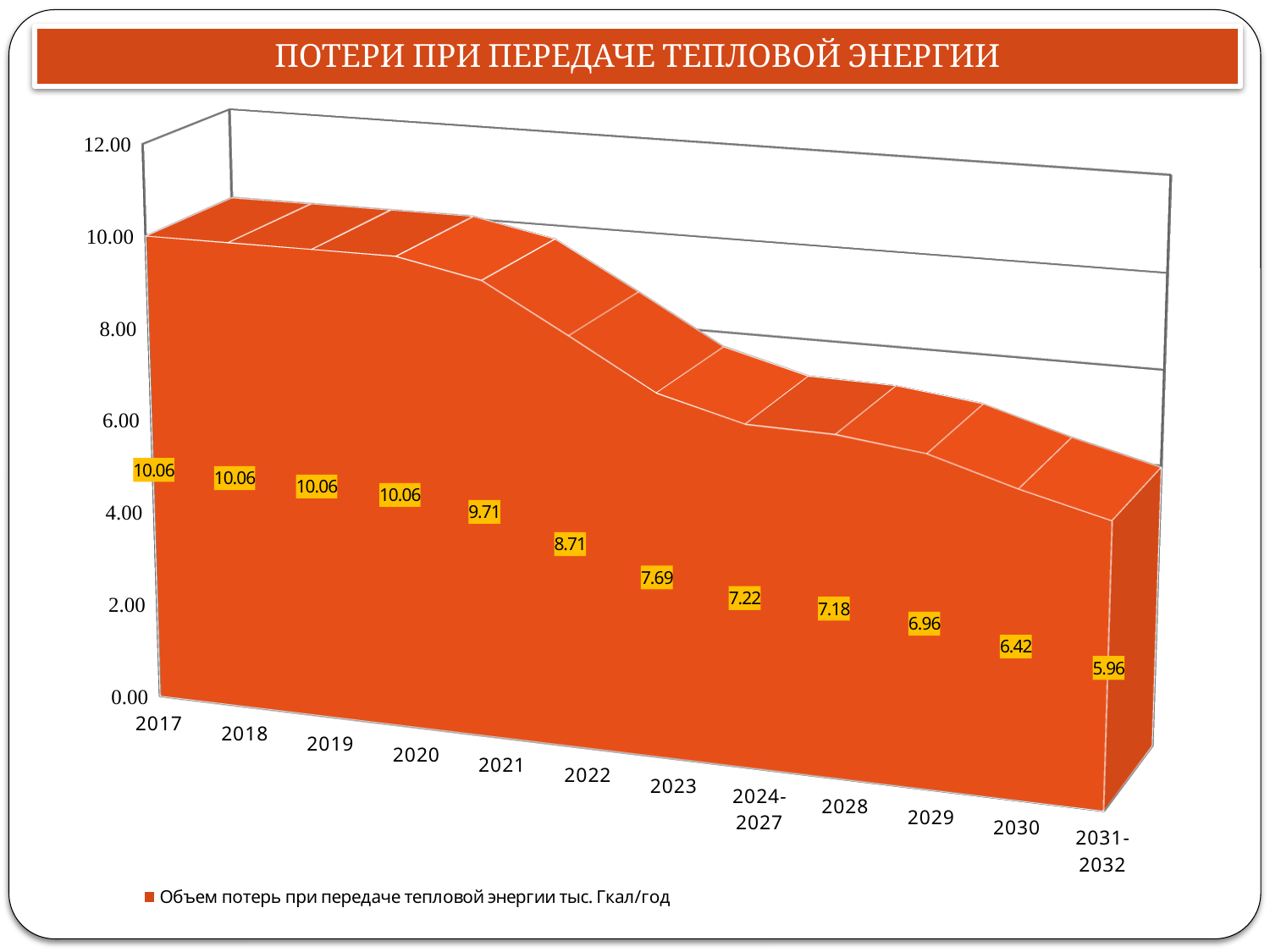
Which category has the lowest value? 2031-2032 What is the difference between the values for 2017 and 2031-2032? 4.10 Which is larger, the value for 2021 or the value for 2030? 2021 What is the value for 2029? 6.96 How many categories are shown on the x axis? 12 What is the value for 2024-2027? 7.22 What is the value for 2031-2032? 5.96 Do the values rise or fall from 2017 to 2031-2032? Fall What kind of chart is shown on the slide? Area chart What is the value for 2021? 9.71 What is the difference between the values for 2022 and 2023? 1.02 How many series does the legend list? 1